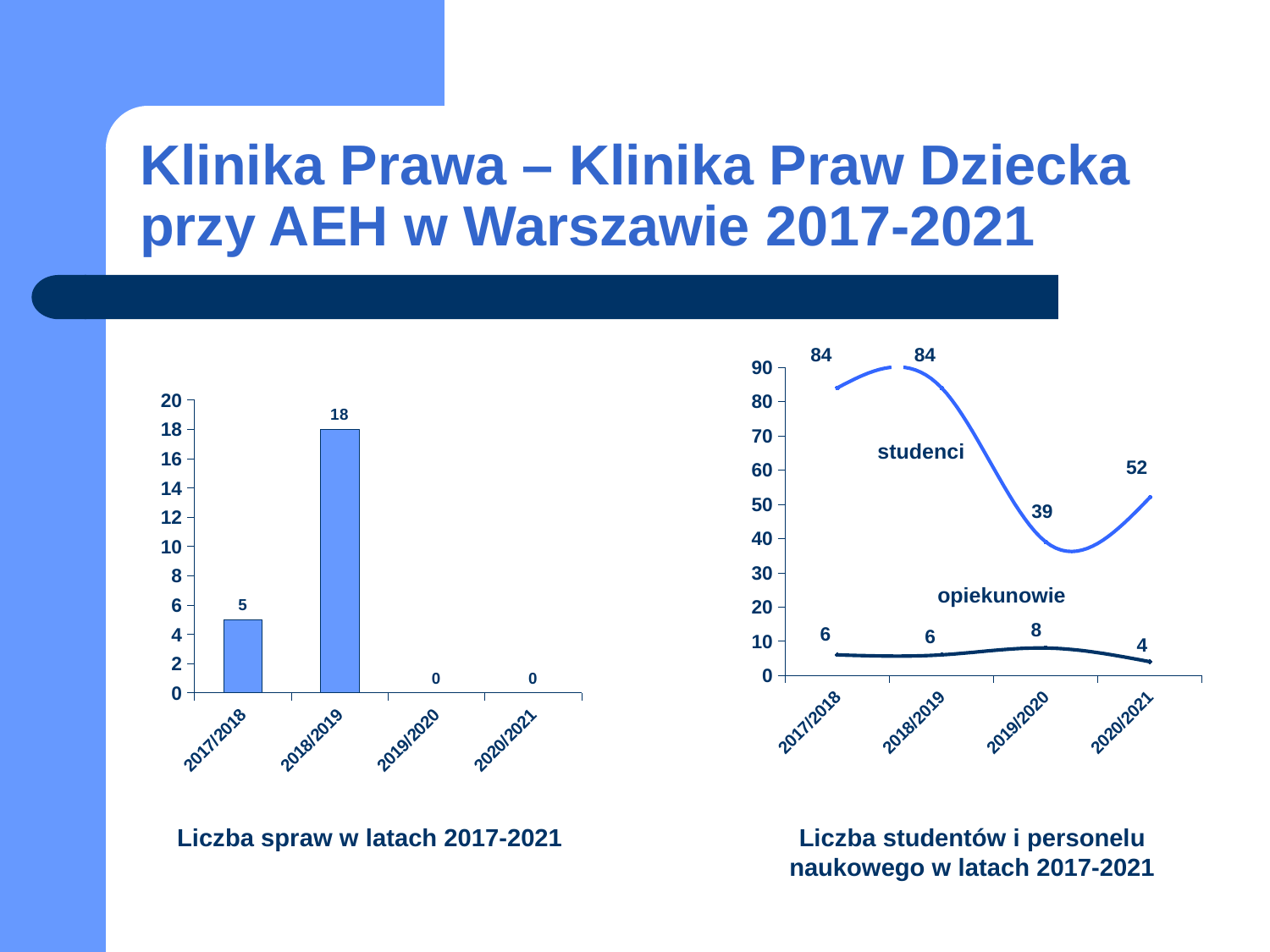
In the right chart (Liczba studentów i personelu naukowego w latach 2017-2021), what is the value for studenci in 2019/2020? 39 In the right chart (Liczba studentów i personelu naukowego w latach 2017-2021), in which year is the opiekunowie value highest? 2019/2020 In the right chart (Liczba studentów i personelu naukowego w latach 2017-2021), how many series are plotted? 2 In the left chart (Liczba spraw w latach 2017-2021), what is the difference between the values for 2018/2019 and 2017/2018? 13 In the left chart (Liczba spraw w latach 2017-2021), what is the value for 2018/2019? 18 In the right chart (Liczba studentów i personelu naukowego w latach 2017-2021), which is larger in 2019/2020: studenci or opiekunowie? studenci In the right chart (Liczba studentów i personelu naukowego w latach 2017-2021), what is the difference between studenci and opiekunowie in 2020/2021? 48 In the left chart (Liczba spraw w latach 2017-2021), how many categories are shown on the x axis? 4 In the left chart (Liczba spraw w latach 2017-2021), which year has the highest value? 2018/2019 What kind of chart is the right chart (Liczba studentów i personelu naukowego w latach 2017-2021)? line chart In the right chart (Liczba studentów i personelu naukowego w latach 2017-2021), what is the value for opiekunowie in 2020/2021? 4 What kind of chart is the left chart (Liczba spraw w latach 2017-2021)? bar chart